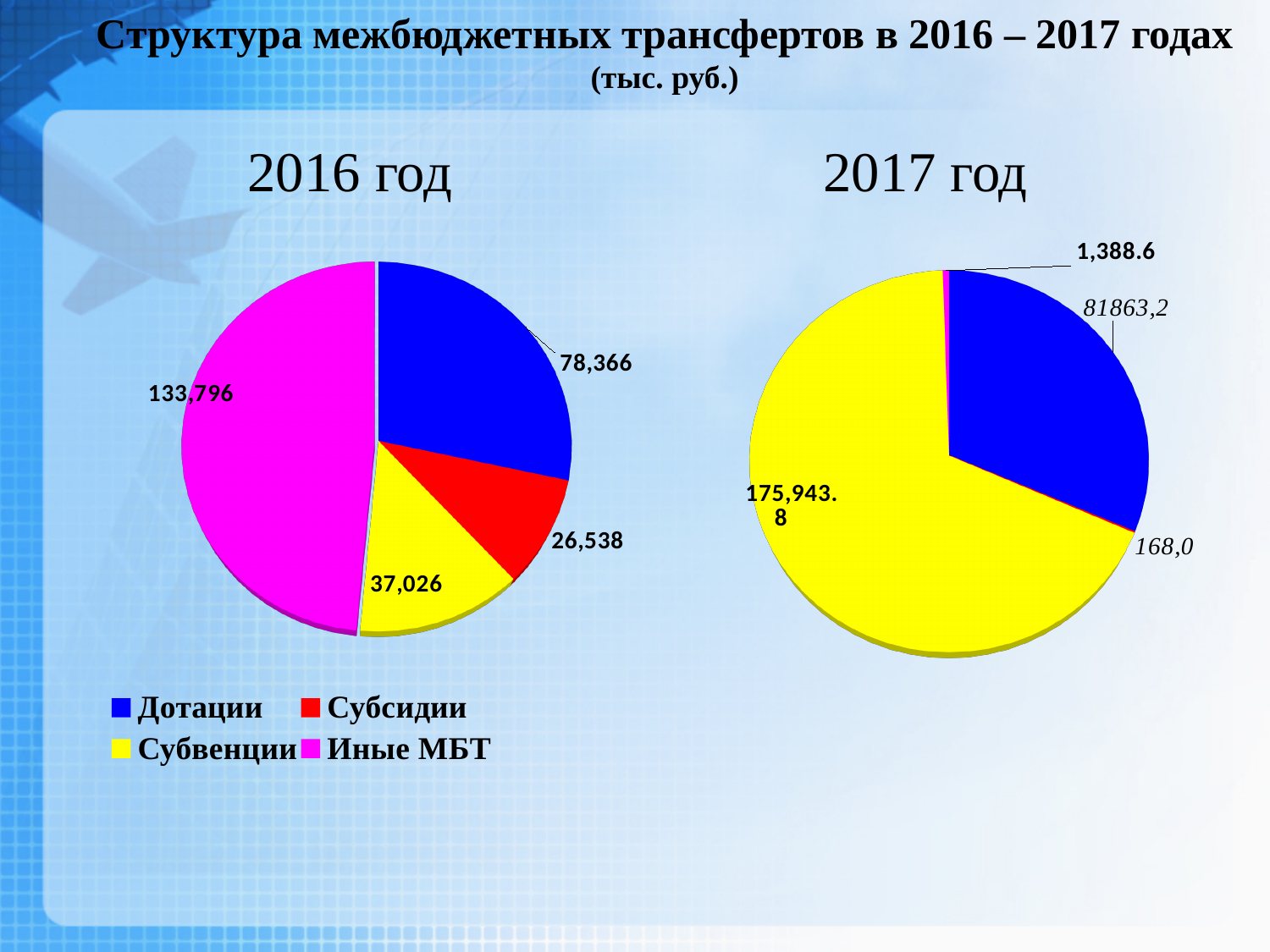
In the 2017 год pie chart, which category has the largest slice? Субвенции In the 2017 год pie chart, what is the value for Субвенции? 175,943.8 In the 2016 год pie chart, what is the value for Субсидии? 26,538 In the 2016 год pie chart, which is larger, Субвенции or Субсидии? Субвенции What type of chart is used for 2016 год and 2017 год? Pie chart In the 2016 год pie chart, what is the difference between Иные МБТ and Дотации? 55,430 In the 2016 год pie chart, which category has the smallest slice? Субсидии How many categories does the legend list? 4 In the 2016 год pie chart, what is the value for Иные МБТ? 133,796 In the 2017 год pie chart, what is the value for Дотации? 81863,2 In the 2016 год pie chart, which category has the largest slice? Иные МБТ In the 2016 год pie chart, what is the value for Дотации? 78,366